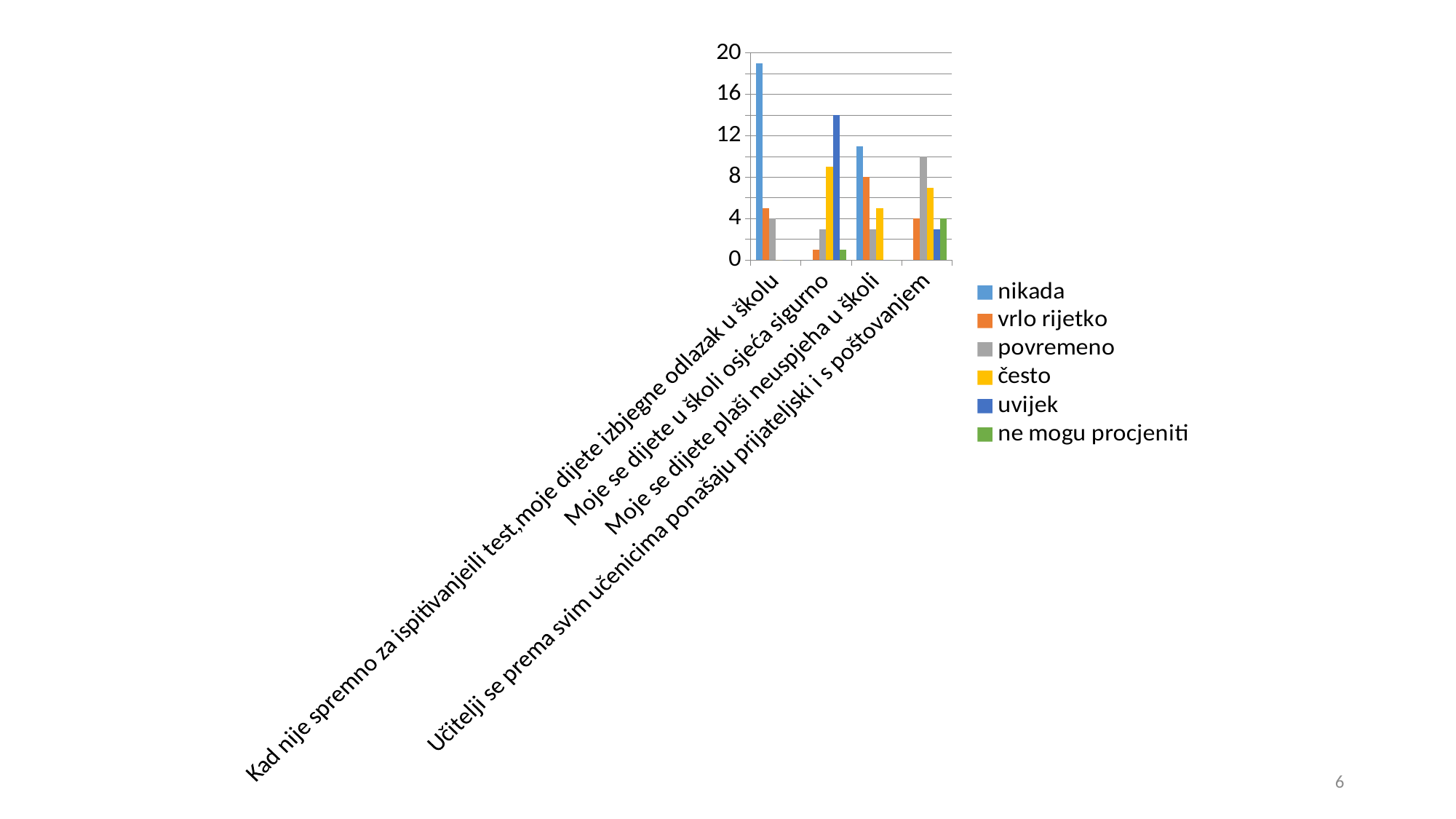
Is the value for 'uvijek' in the category 'Moje se dijete u školi osjeća sigurno' greater or less than 12? greater Is the value for 'često' in the category 'Moje se dijete plaši neuspjeha u školi' greater or less than 8? less Which series has the highest bar for the category 'Kad nije spremno za ispitivanje ili test, moje dijete izbjegne odlazak u školu'? nikada What is the highest value shown on the vertical axis? 20 Is the value for 'nikada' in the category 'Kad nije spremno za ispitivanje ili test, moje dijete izbjegne odlazak u školu' greater or less than 16? greater How many series does the legend list? 6 For the category 'Moje se dijete plaši neuspjeha u školi', which is larger: the 'nikada' bar or the 'vrlo rijetko' bar? nikada For the category 'Moje se dijete u školi osjeća sigurno', which is larger: the 'često' bar or the 'povremeno' bar? često Which series has the highest bar for the category 'Učitelji se prema svim učenicima ponašaju prijateljski i s poštovanjem'? povremeno How many categories are shown on the x axis? 4 What kind of chart is shown on the slide? bar chart Which series has the highest bar for the category 'Moje se dijete u školi osjeća sigurno'? uvijek